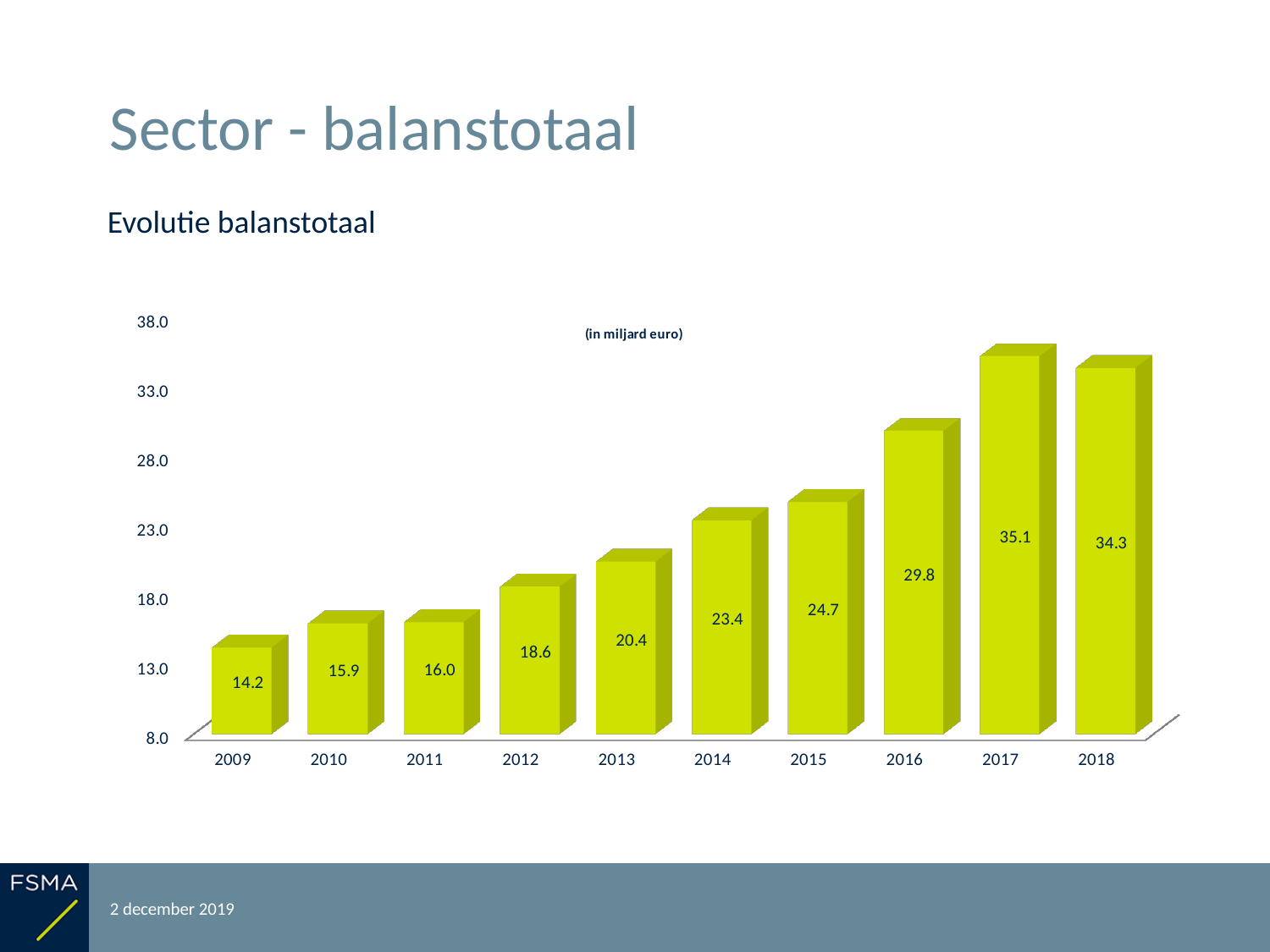
What is the difference between the values for 2017 and 2018? 0.8 Which year has the lowest value? 2009 Which year has the highest value? 2017 What is the difference between the values for 2016 and 2015? 5.1 Which is larger, the value for 2013 or the value for 2014? 2014 Is the value for 2015 greater or less than 23.0? greater What is the value for 2009? 14.2 What is the value for 2018? 34.3 What unit is stated in the chart's label? in miljard euro How many years are shown on the x axis? 10 What kind of chart is shown? bar chart What is the value for 2016? 29.8